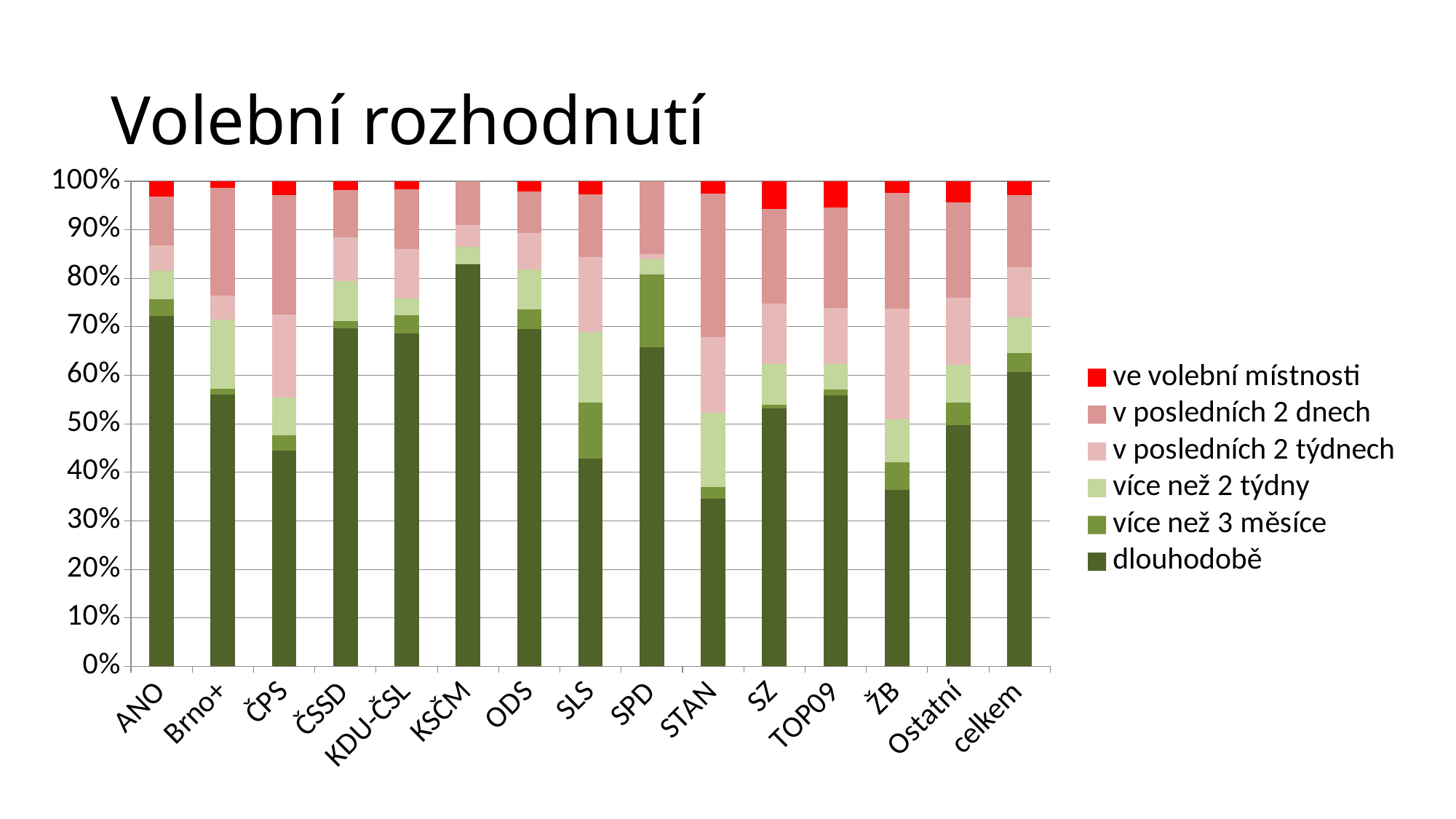
What is the title of the chart? Volební rozhodnutí Is the 'dlouhodobě' value for STAN greater or less than 40%? less How many series does the legend list? 6 How many categories are shown along the x axis? 15 Which category has the smallest 'dlouhodobě' segment? STAN Is the 'dlouhodobě' value for KSČM greater or less than 80%? greater Which legend entry is shown in red? ve volební místnosti Which category has the largest 'dlouhodobě' segment? KSČM Which has a larger 'dlouhodobě' segment, Brno+ or ŽB? Brno+ Is the 'dlouhodobě' value for ČPS greater or less than 50%? less What kind of chart is shown on the slide? stacked bar chart